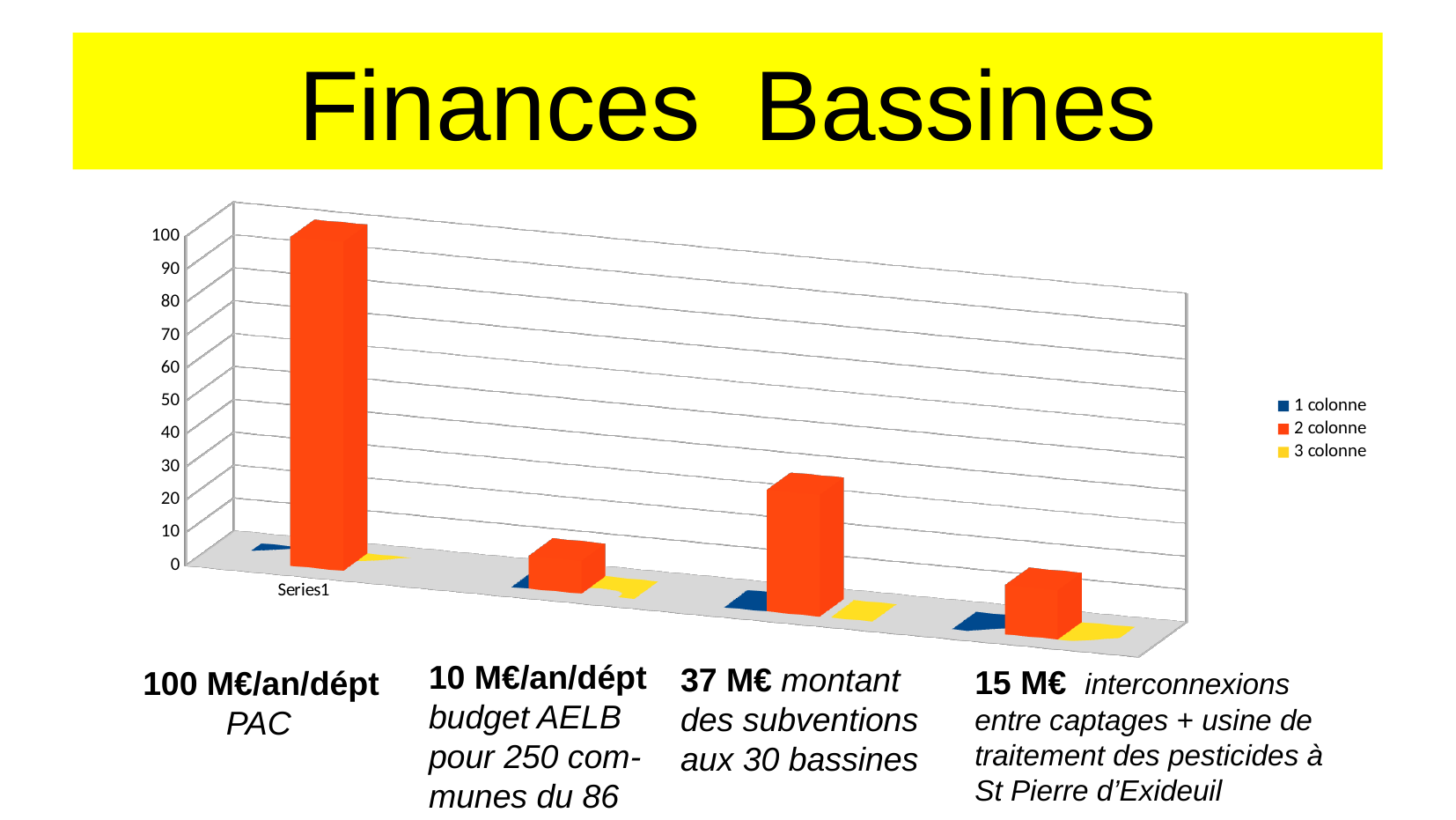
How many series does the chart legend list? 3 What colour represents the '2 colonne' series in the legend? orange What value does the '2 colonne' bar for Series1 reach on the axis? 100 Which is larger: the '2 colonne' bar for Series1 or the one for 'budget AELB'? Series1 What is the title shown at the top of the slide? Finances Bassines Which group has the tallest '2 colonne' bar? Series1 (100 M€/an/dépt PAC) How many groups of bars are plotted in the chart? 4 What kind of chart is shown on the slide? bar chart Is the '2 colonne' bar for the 'subventions aux 30 bassines' group greater or less than 50? less Is the '2 colonne' bar for the 'budget AELB' group greater or less than 50? less Which is larger: the '2 colonne' bar for 'subventions aux 30 bassines' or the one for 'interconnexions entre captages'? subventions aux 30 bassines Which group has the shortest '2 colonne' bar? budget AELB pour 250 communes du 86